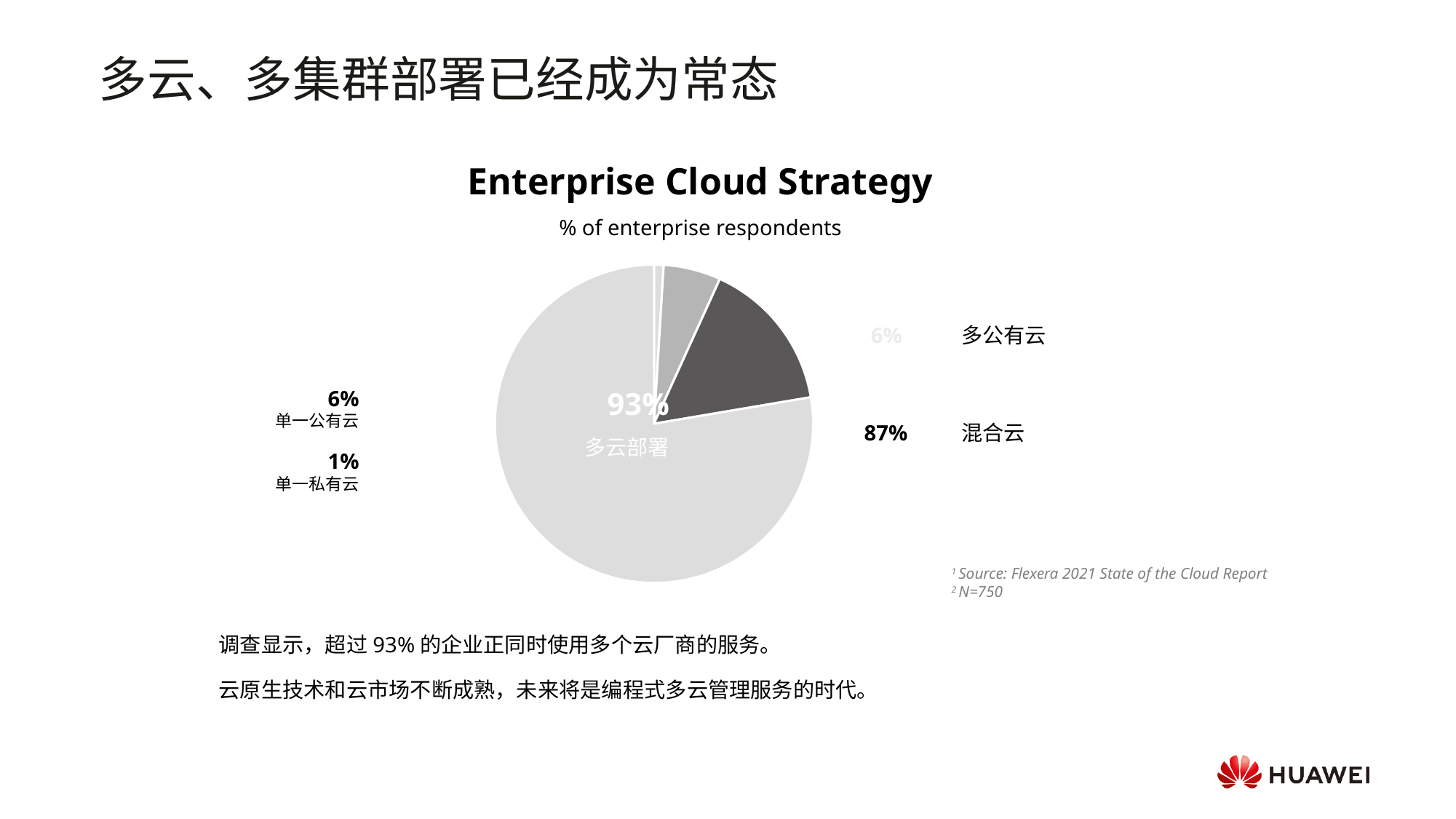
What percentage is shown for 单一公有云? 6% What percentage is shown for 单一私有云? 1% What percentage is labelled in the centre of the pie for 多云部署? 93% What kind of chart is shown on the slide? pie chart Which is larger, the share for 混合云 or the share for 单一私有云? 混合云 What is the difference in percentage points between 混合云 and 单一公有云? 81 Which category has the largest share of the pie? 混合云 Which category has the smallest share of the pie? 单一私有云 How many slices does the pie chart have? 4 What percentage of enterprise respondents does the 混合云 slice represent? 87% What is the title of the chart? Enterprise Cloud Strategy What percentage is shown for 多公有云? 6%